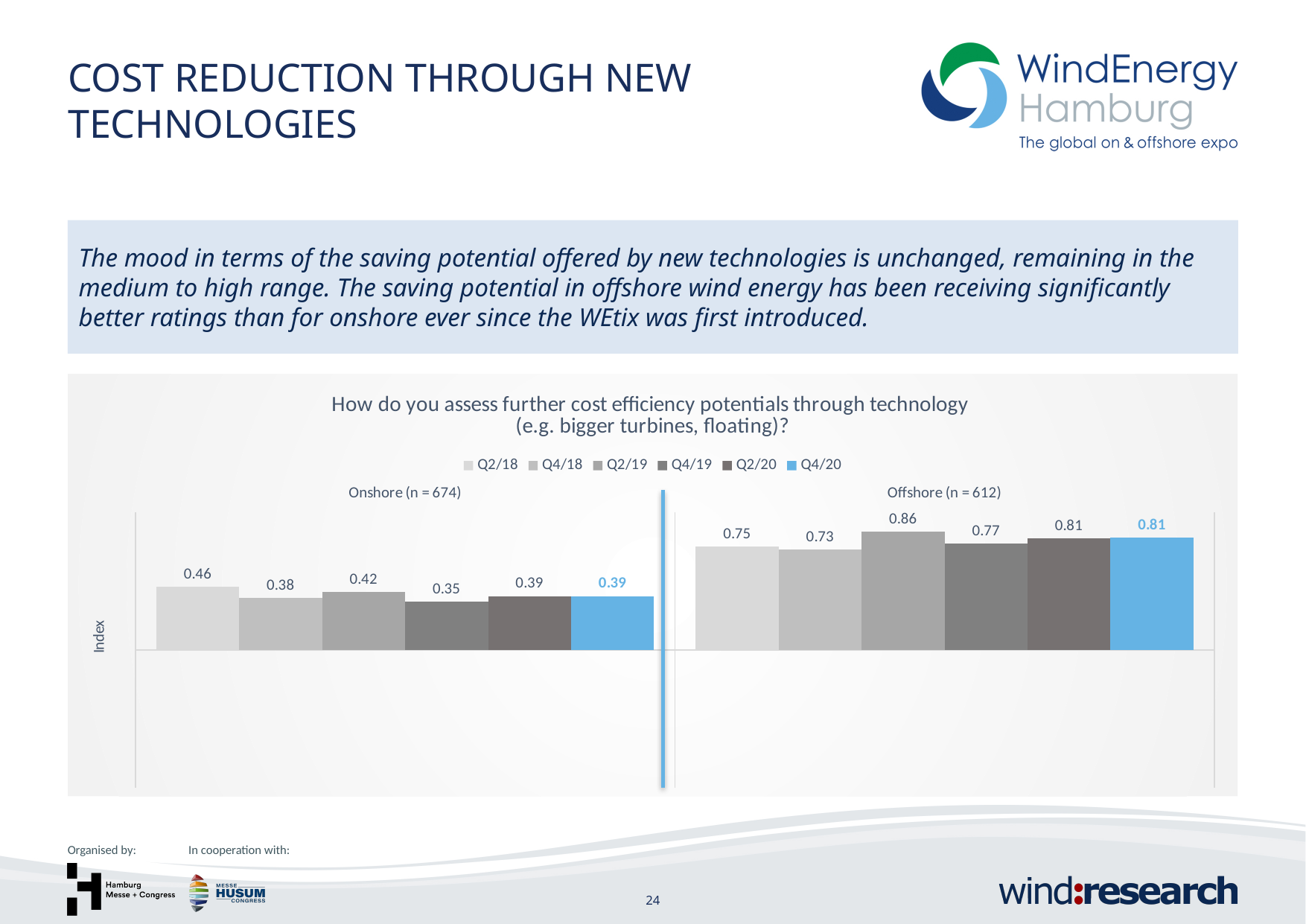
What kind of chart is shown on the slide? Bar chart What is the Onshore value for Q4/20? 0.39 What is the sample size (n) shown for the Offshore group? 612 What is the difference between the Offshore and Onshore values for Q4/20? 0.42 How many series does the legend list? 6 What is the Onshore value for Q2/18? 0.46 What is the difference between the Onshore values for Q2/18 and Q4/18? 0.08 Which is larger, the Offshore value for Q4/19 or the Offshore value for Q2/18? Offshore Q4/19 What is the Offshore value for Q2/19? 0.86 What is the Offshore value for Q4/18? 0.73 Which survey wave has the lowest Onshore value? Q4/19 Which survey wave has the highest Offshore value? Q2/19